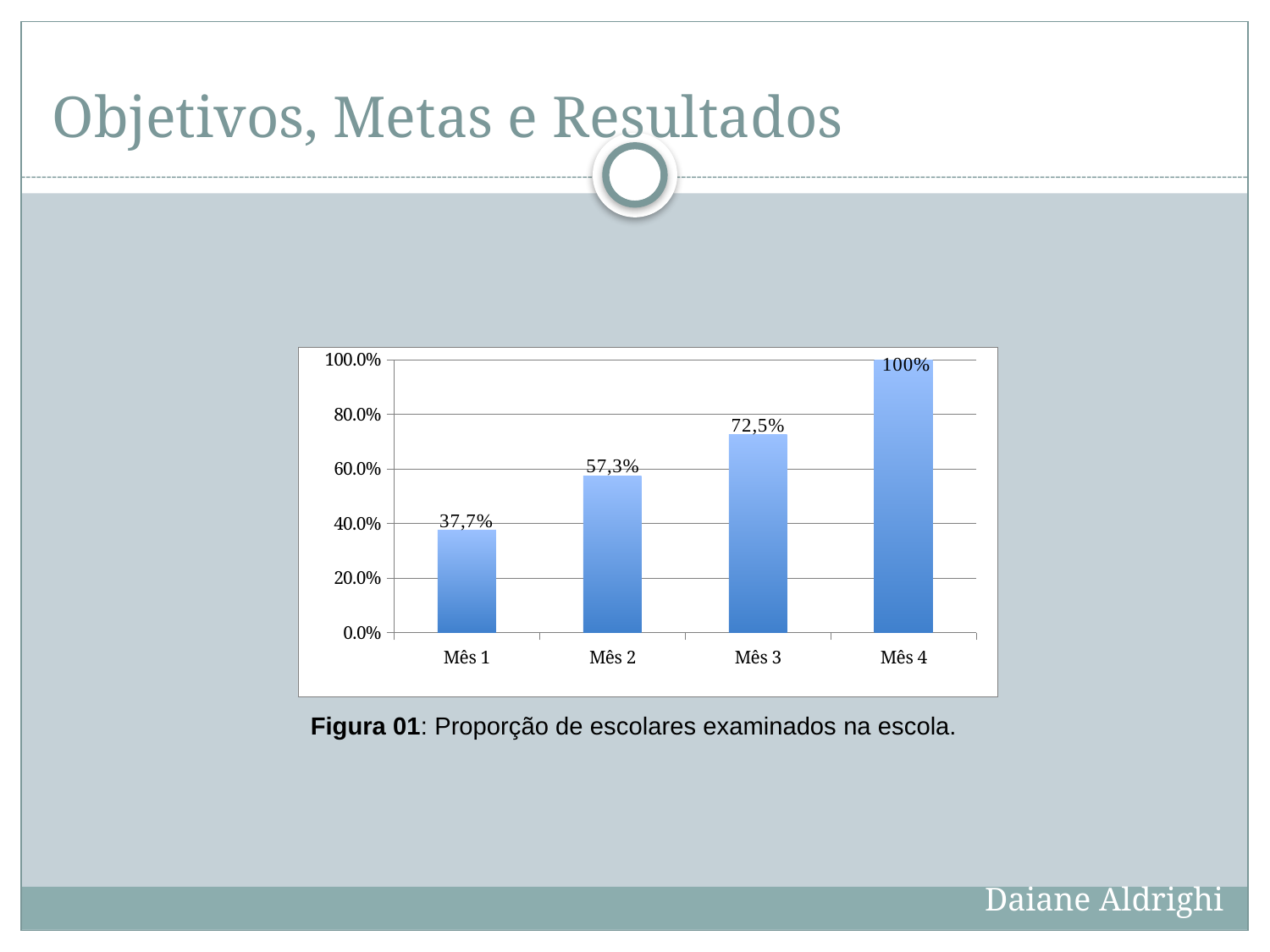
What is the difference between the values for Mês 4 and Mês 3? 27,5% Which is larger, the value for Mês 2 or the value for Mês 3? Mês 3 What is the value for Mês 1? 37,7% Is the value for Mês 2 greater or less than 60.0%? less What is the value for Mês 3? 72,5% Do the values rise or fall from Mês 1 to Mês 4? Rise How many months are shown on the x axis? 4 What kind of chart is shown on the slide? Bar chart What is the value for Mês 4? 100% Which month has the lowest value? Mês 1 What is the difference between the values for Mês 2 and Mês 1? 19,6% Which month has the highest value? Mês 4